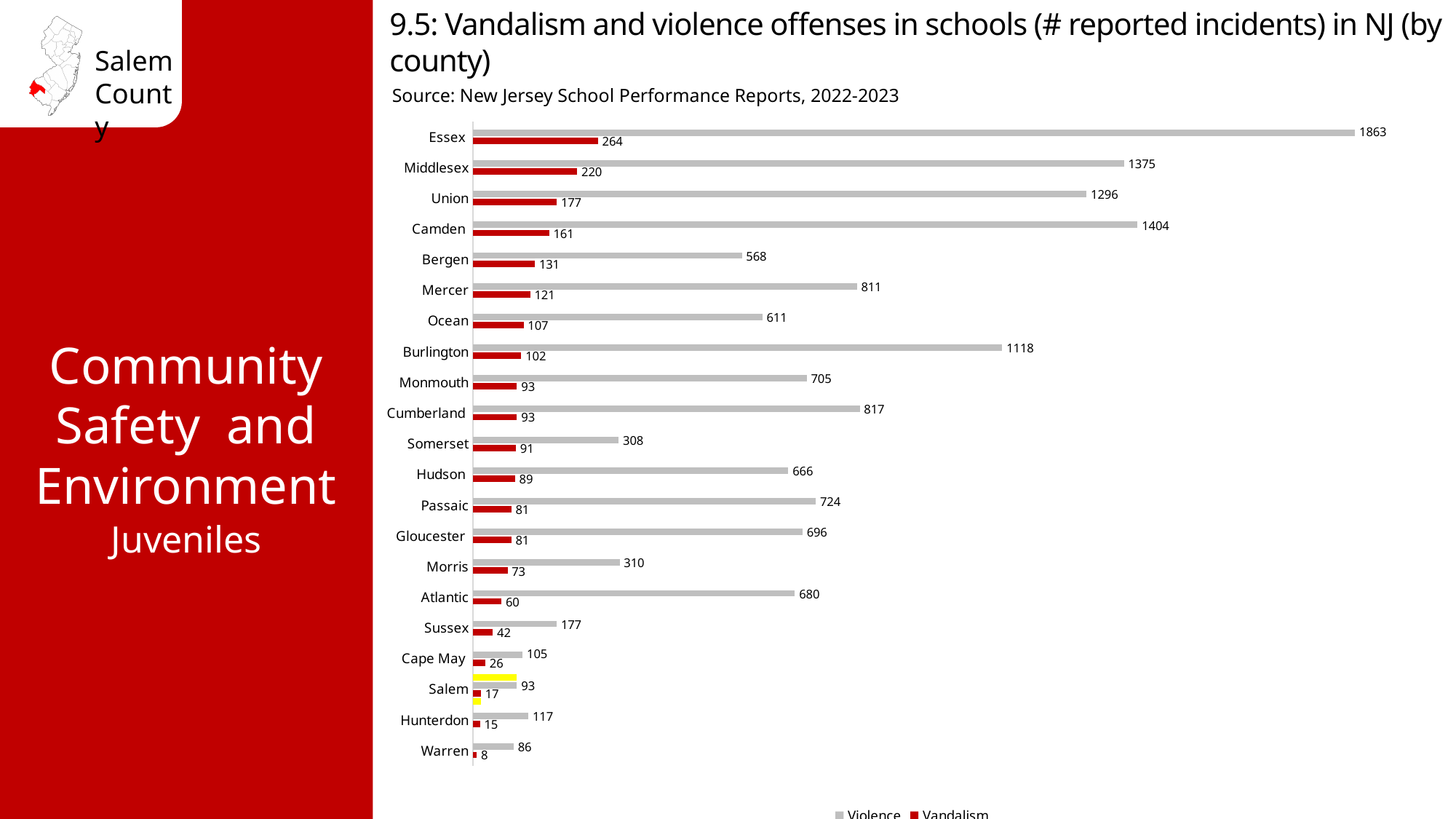
What is the number of reported violence incidents for Burlington County? 1118 What is the number of reported vandalism incidents for Salem County? 17 What kind of chart is shown on the slide? Bar chart What is the number of reported violence incidents for Salem County? 93 How many counties are shown in the chart? 21 How many series does the legend list? 2 What is the difference between the violence incidents in Essex and Middlesex? 488 Which county has more reported violence incidents, Camden or Union? Camden Which county has the highest number of reported violence incidents? Essex Which county has the lowest number of reported vandalism incidents? Warren What is the difference between violence and vandalism incidents in Salem County? 76 Do the vandalism values rise or fall going from Essex at the top to Warren at the bottom? Fall